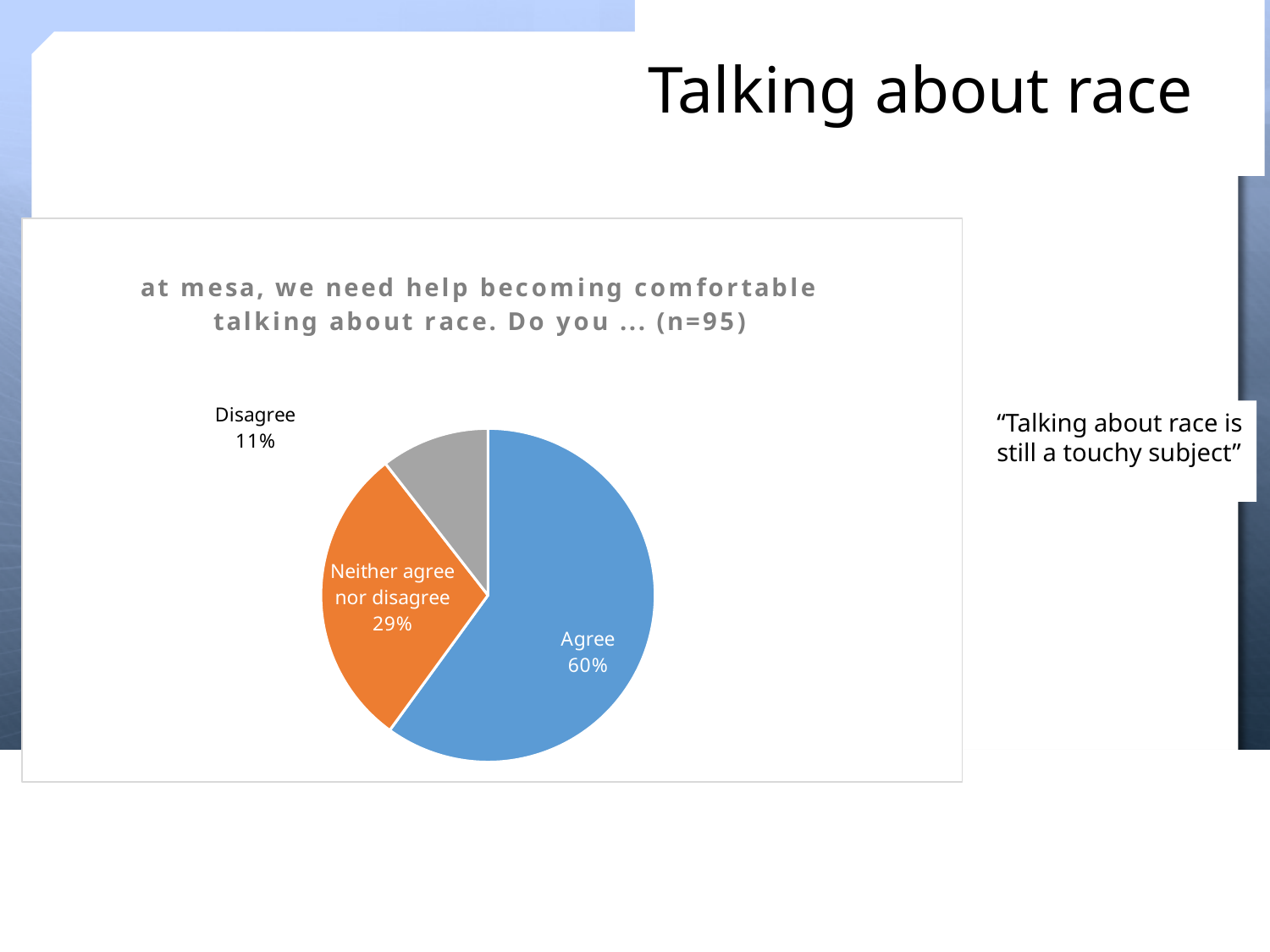
How many slices does the pie chart have? 3 Which is larger, the share for Neither agree nor disagree or the share for Disagree? Neither agree nor disagree What share of respondents chose Agree? 60% What share of respondents chose Disagree? 11% Which response has the largest share of the pie? Agree What kind of chart is shown on the slide? Pie chart Which response has the smallest share of the pie? Disagree What is the difference in percentage points between Agree and Disagree? 49 What is the difference in percentage points between Agree and Neither agree nor disagree? 31 What colour is the Agree slice? Blue What share of respondents chose Neither agree nor disagree? 29% What sample size (n) is given in the chart title? 95